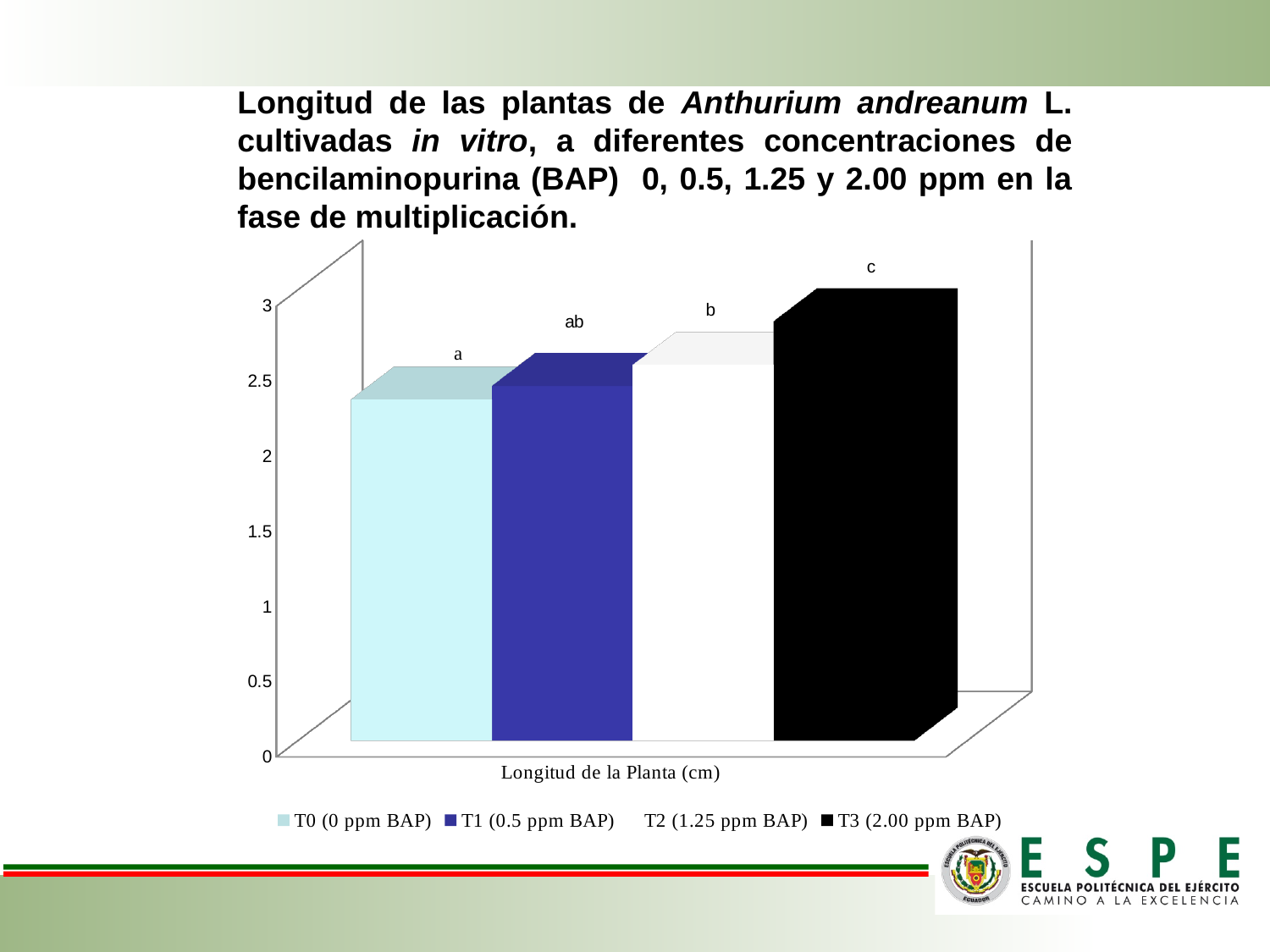
Is the value for T3 (2.00 ppm BAP) greater or less than 2.5? greater Is the value for T0 (0 ppm BAP) greater or less than 2.5? less Which is larger, the value for T2 (1.25 ppm BAP) or the value for T0 (0 ppm BAP)? T2 (1.25 ppm BAP) Which is larger, the value for T3 (2.00 ppm BAP) or the value for T0 (0 ppm BAP)? T3 (2.00 ppm BAP) What letter is printed above the bar for T3 (2.00 ppm BAP)? c What kind of chart is shown on the slide? bar chart Do the bar values rise or fall from T0 to T3 across the chart? rise What is the label shown on the horizontal axis of the chart? Longitud de la Planta (cm) Is the value for T0 (0 ppm BAP) greater or less than 2? greater Which treatment has the highest plant length? T3 (2.00 ppm BAP) How many series does the legend list? 4 Which treatment has the lowest plant length? T0 (0 ppm BAP)